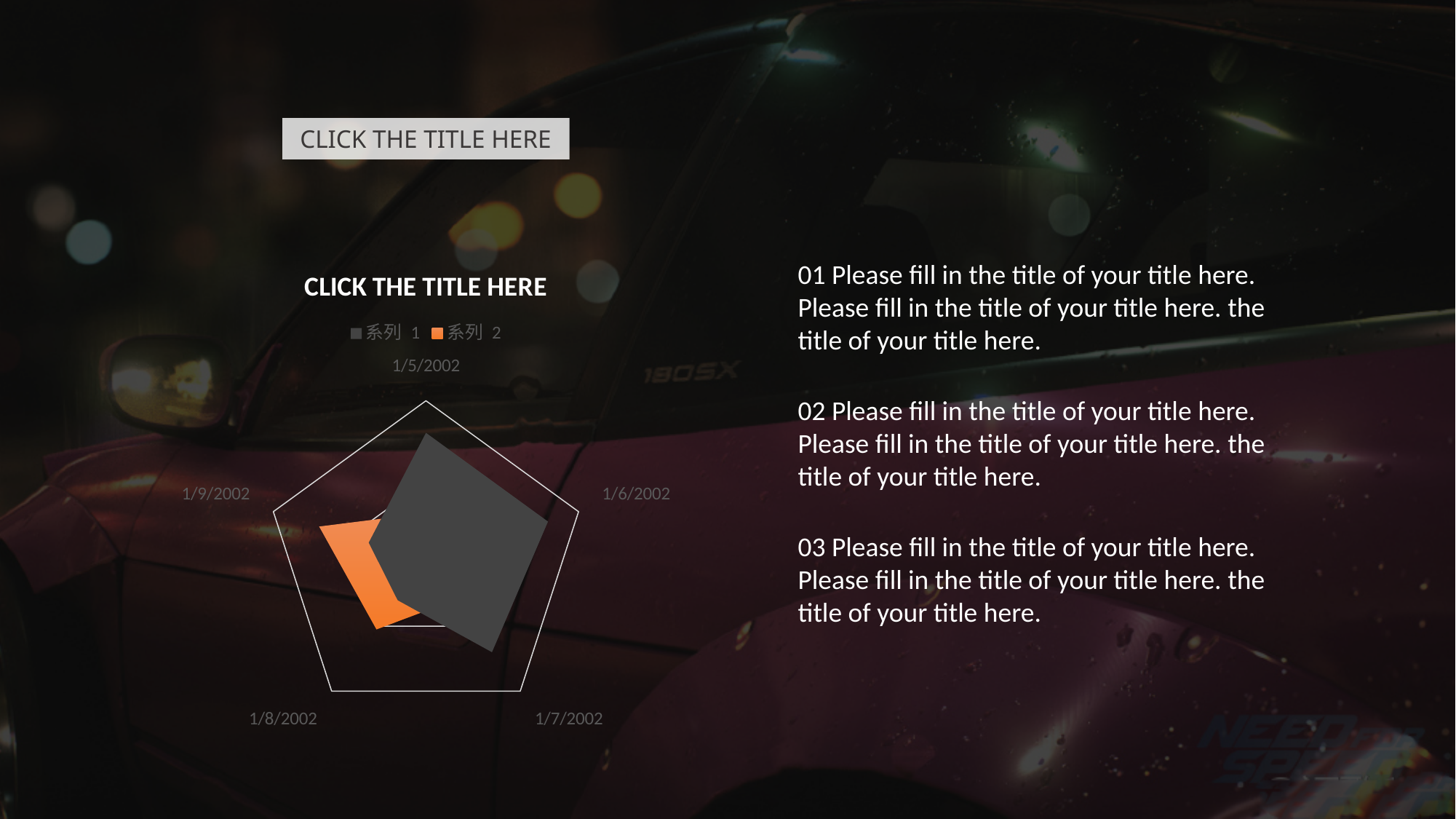
Which series extends further toward the 1/9/2002 axis, 系列 1 or 系列 2? 系列 2 Which series extends further toward the 1/6/2002 axis, 系列 1 or 系列 2? 系列 1 Which category label appears at the top of the radar chart? 1/5/2002 What kind of chart is shown on the slide? Radar chart What is the title of the radar chart? CLICK THE TITLE HERE How many series does the legend of the radar chart list? 2 Which colour represents 系列 2 in the radar chart? Orange How many categories (axes) does the radar chart have? 5 Which series extends further toward the 1/5/2002 axis, 系列 1 or 系列 2? 系列 1